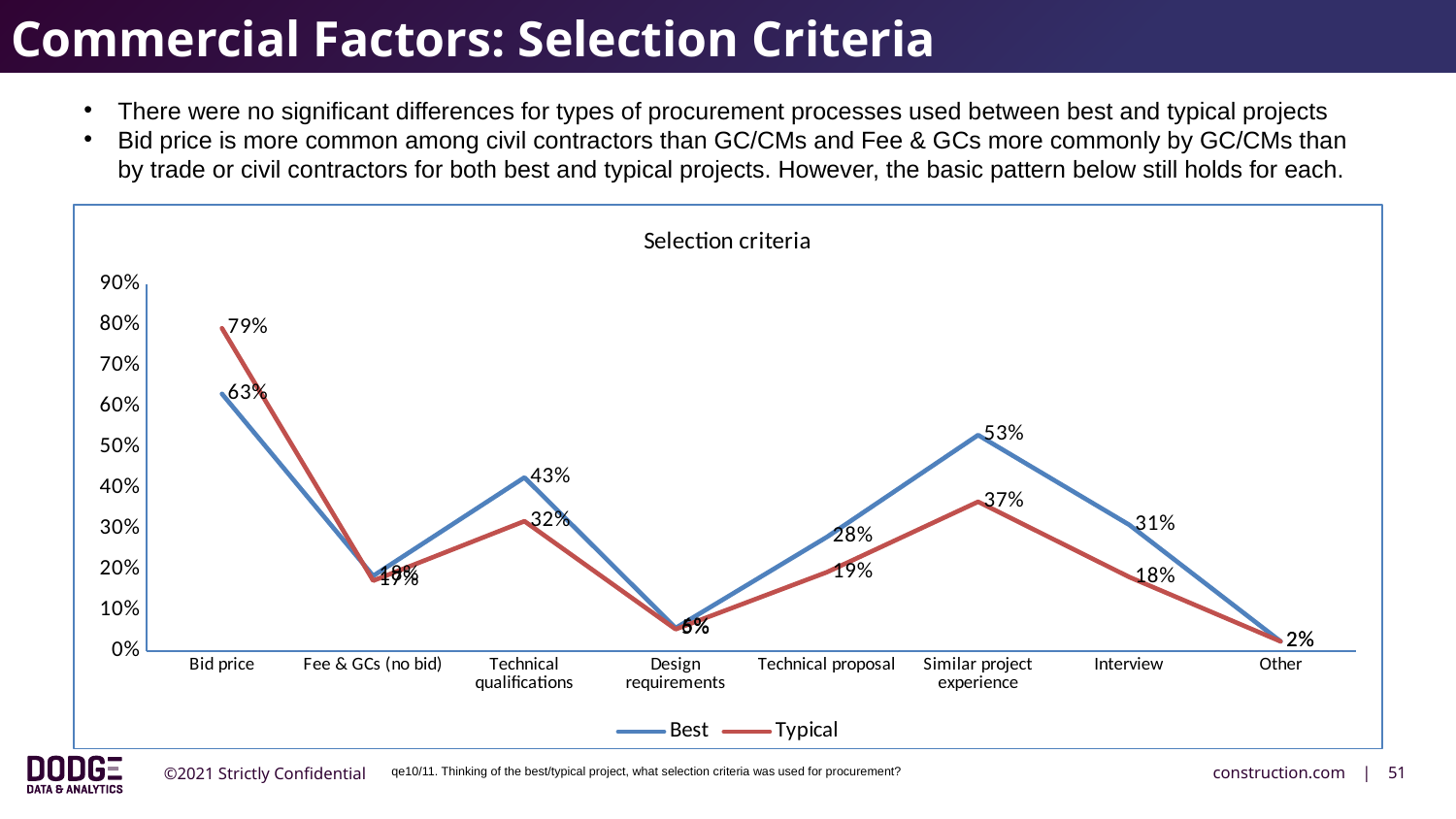
How many categories are shown on the x axis? 8 Which is larger for Technical proposal: the Best value or the Typical value? Best What is the value for Similar project experience in the Best series? 53% What is the value for Interview in the Typical series? 18% What is the difference between the Best and Typical values for Technical qualifications? 11% What is the value for Bid price in the Best series? 63% Is the value for Similar project experience in the Typical series greater or less than 30%? greater How many series does the legend list? 2 What is the title of the chart? Selection criteria Which category has the highest value in the Typical series? Bid price What type of chart is shown on the slide? Line chart What is the value for Bid price in the Typical series? 79%